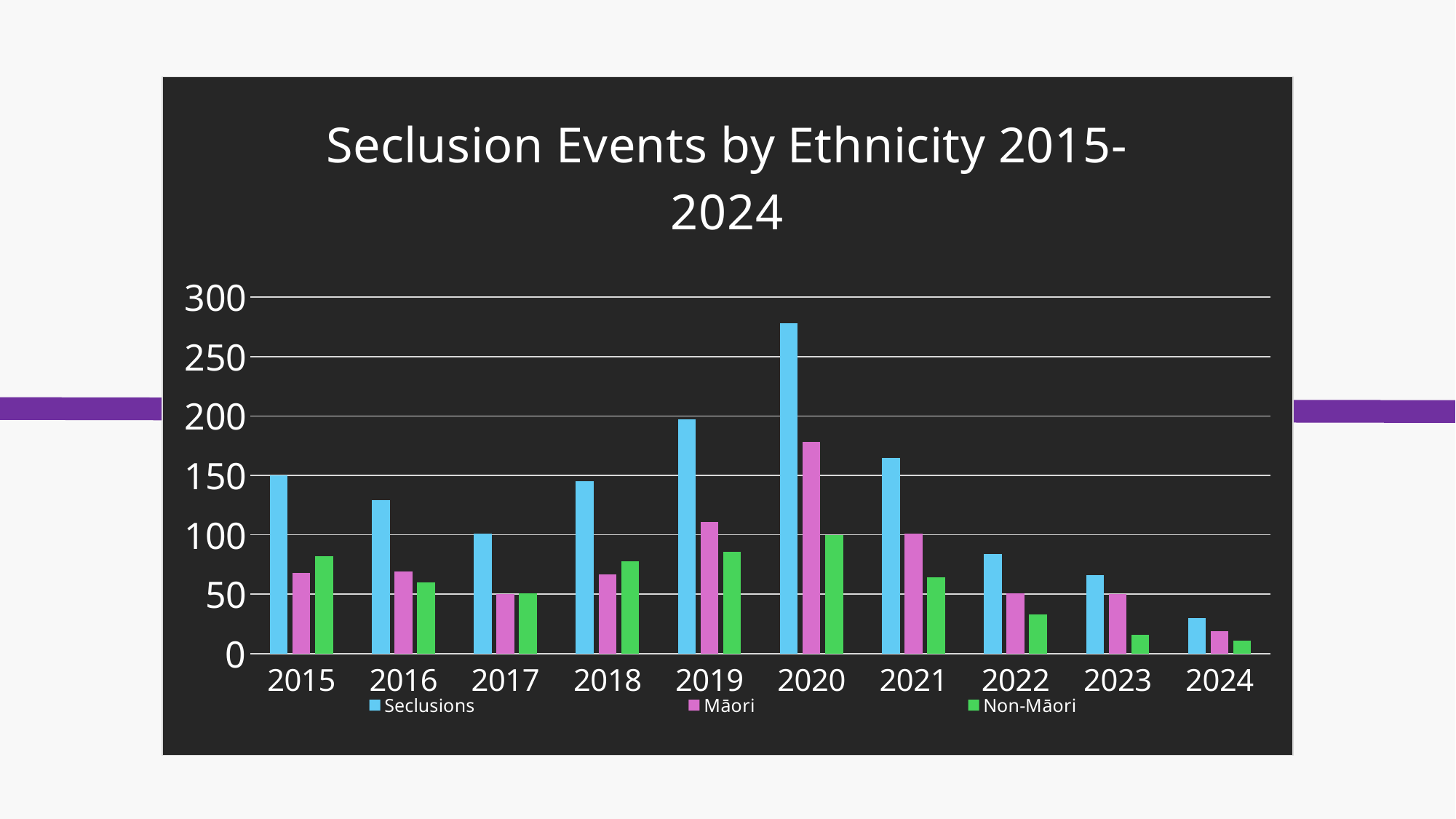
Is the Non-Māori value for 2023 greater or less than 50? less Do the Seclusions values rise or fall from 2020 to 2024? fall What kind of chart is shown on the slide? Bar chart In which year is the Seclusions value highest? 2020 In 2015, which is larger: the Māori value or the Non-Māori value? Non-Māori How many years are shown on the x axis? 10 In which year is the Non-Māori value highest? 2020 What is the title of the chart? Seclusion Events by Ethnicity 2015-2024 Is the Māori value for 2020 greater or less than 150? greater How many series does the legend list? 3 In which year is the Seclusions value lowest? 2024 Is the Seclusions value for 2020 greater or less than 250? greater